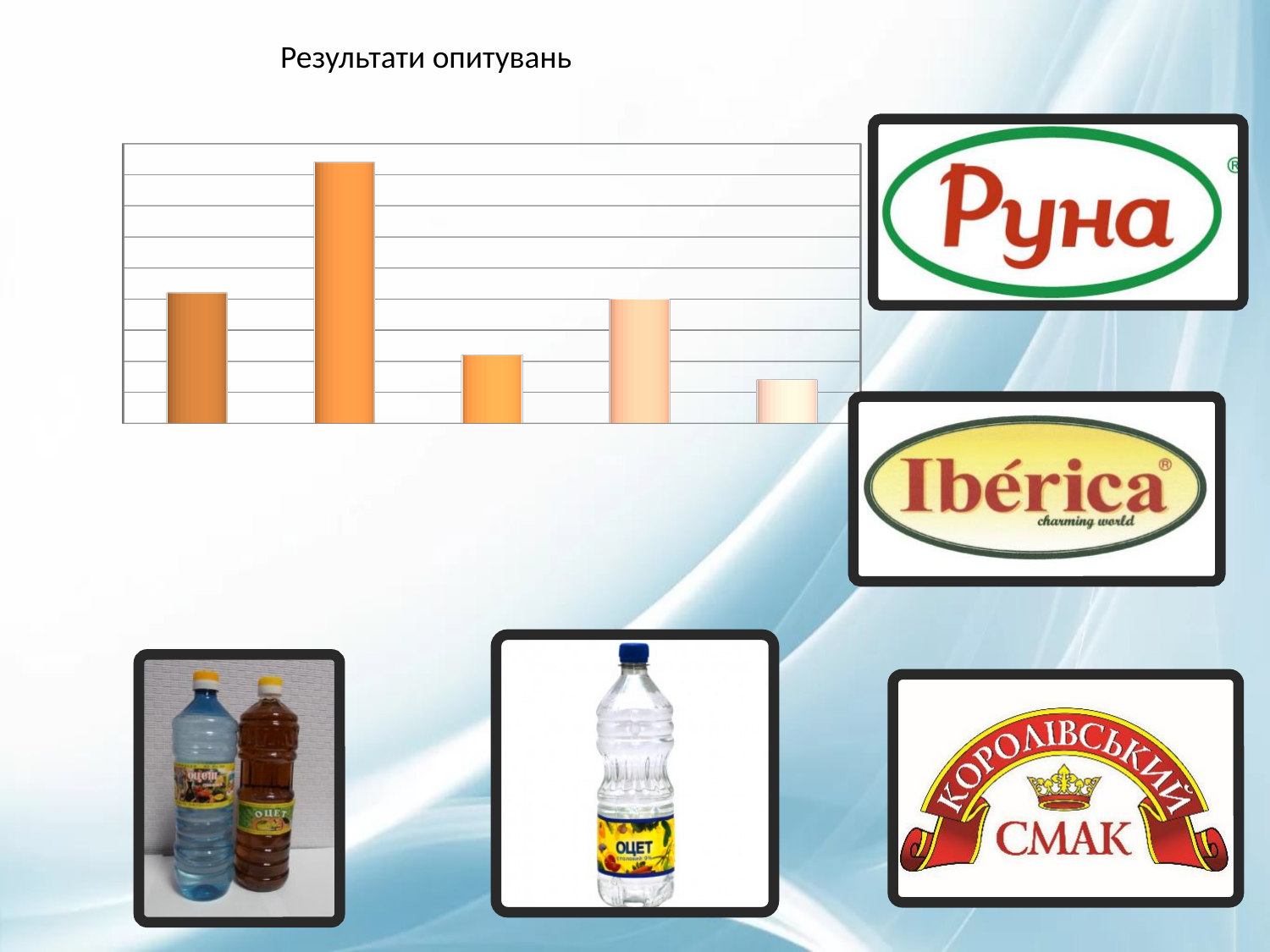
What is the title shown above the chart on the slide? Результати опитувань Which is taller in the chart: the first bar or the third bar from the left? the first bar Which is taller in the chart: the second bar or the third bar from the left? the second bar How many bars does the chart contain? 5 Which bar in the chart is the tallest, counting from the left? the second bar What kind of chart is shown on the slide? bar chart Does the chart display a legend? No Which is taller in the chart: the third bar or the fifth bar from the left? the third bar Which bar in the chart is the shortest, counting from the left? the fifth bar